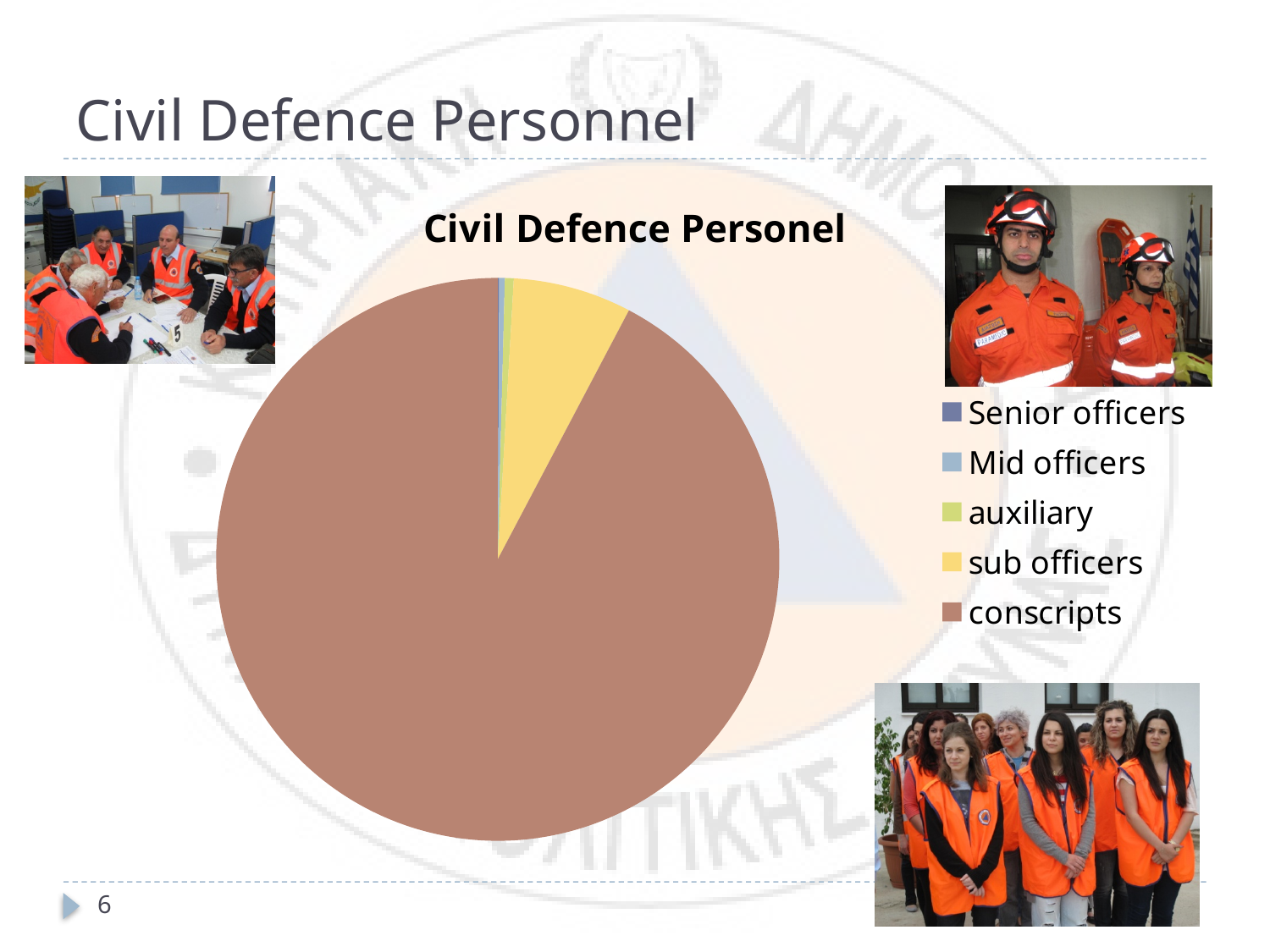
Which category has the largest slice of the pie? conscripts What colour is the slice for conscripts? brown Which is larger, the slice for conscripts or the slice for sub officers? conscripts Which legend entry is listed first? Senior officers Which category has the second-largest slice of the pie? sub officers What is the title of the chart? Civil Defence Personel Is the share of the pie for sub officers greater or less than half? less How many categories does the pie chart's legend list? 5 Is the share of the pie for conscripts greater or less than half? greater Which is larger, the slice for sub officers or the slice for auxiliary? sub officers What kind of chart is shown on the slide? pie chart